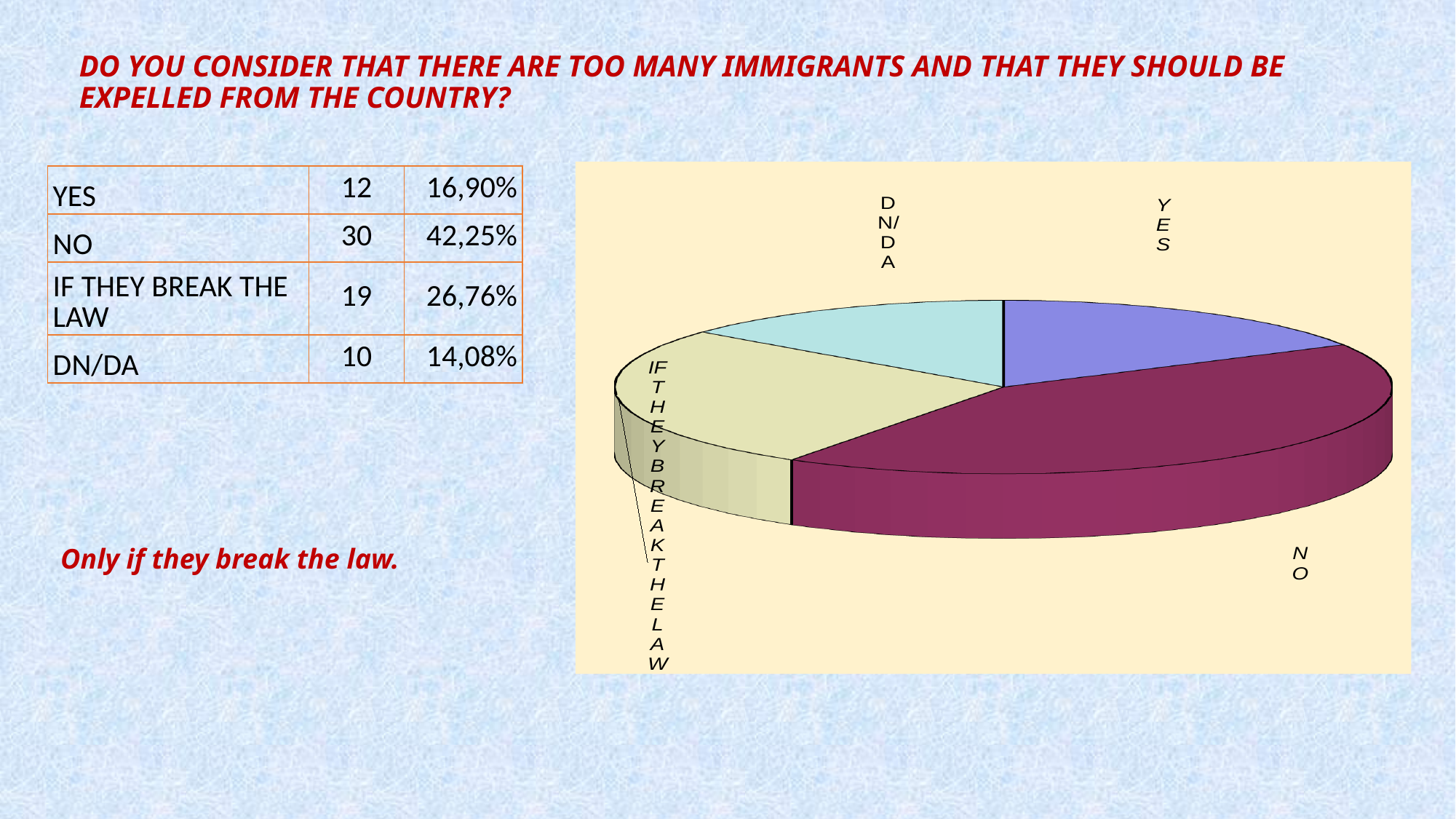
Is the slice for IF THEY BREAK THE LAW larger or smaller than the slice for YES? larger Which category has the smallest slice of the pie chart? DN/DA What is the difference in the number of respondents between NO and YES, using the table values? 18 Which category has the largest slice of the pie chart? NO What colour is the NO slice of the pie chart? dark magenta What is the total number of respondents across all four categories in the table? 71 According to the table on the slide, what percentage of respondents answered YES? 16,90% What kind of chart is shown on the slide? pie chart How many slices does the pie chart have? 4 According to the table on the slide, how many respondents answered IF THEY BREAK THE LAW? 19 According to the table on the slide, how many respondents answered NO? 30 What share of the pie does the DN/DA slice represent, according to the table? 14,08%